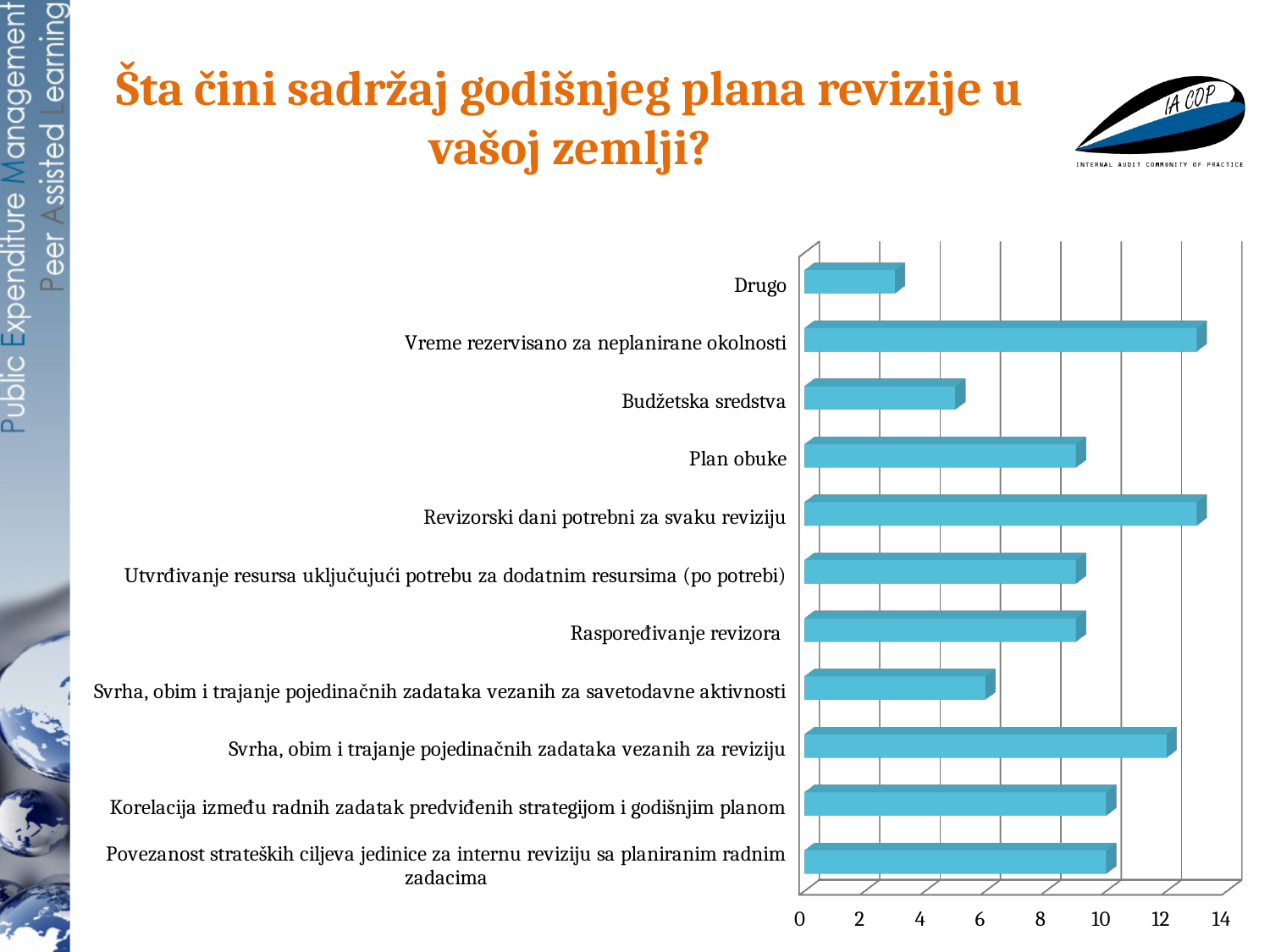
Which is larger, the value for Budžetska sredstva or the value for Plan obuke? Plan obuke Is the value for Svrha, obim i trajanje pojedinačnih zadataka vezanih za savetodavne aktivnosti greater or less than 8? less Is the value for Korelacija između radnih zadatak predviđenih strategijom i godišnjim planom greater or less than 8? greater Is the value for Drugo greater or less than 4? less Which category has the lowest value in the chart? Drugo What kind of chart is shown on the slide? bar chart Which is larger, the value for Svrha, obim i trajanje pojedinačnih zadataka vezanih za reviziju or the value for Svrha, obim i trajanje pojedinačnih zadataka vezanih za savetodavne aktivnosti? Svrha, obim i trajanje pojedinačnih zadataka vezanih za reviziju What is the title of the slide containing the chart? Šta čini sadržaj godišnjeg plana revizije u vašoj zemlji? How many categories are plotted in the chart? 11